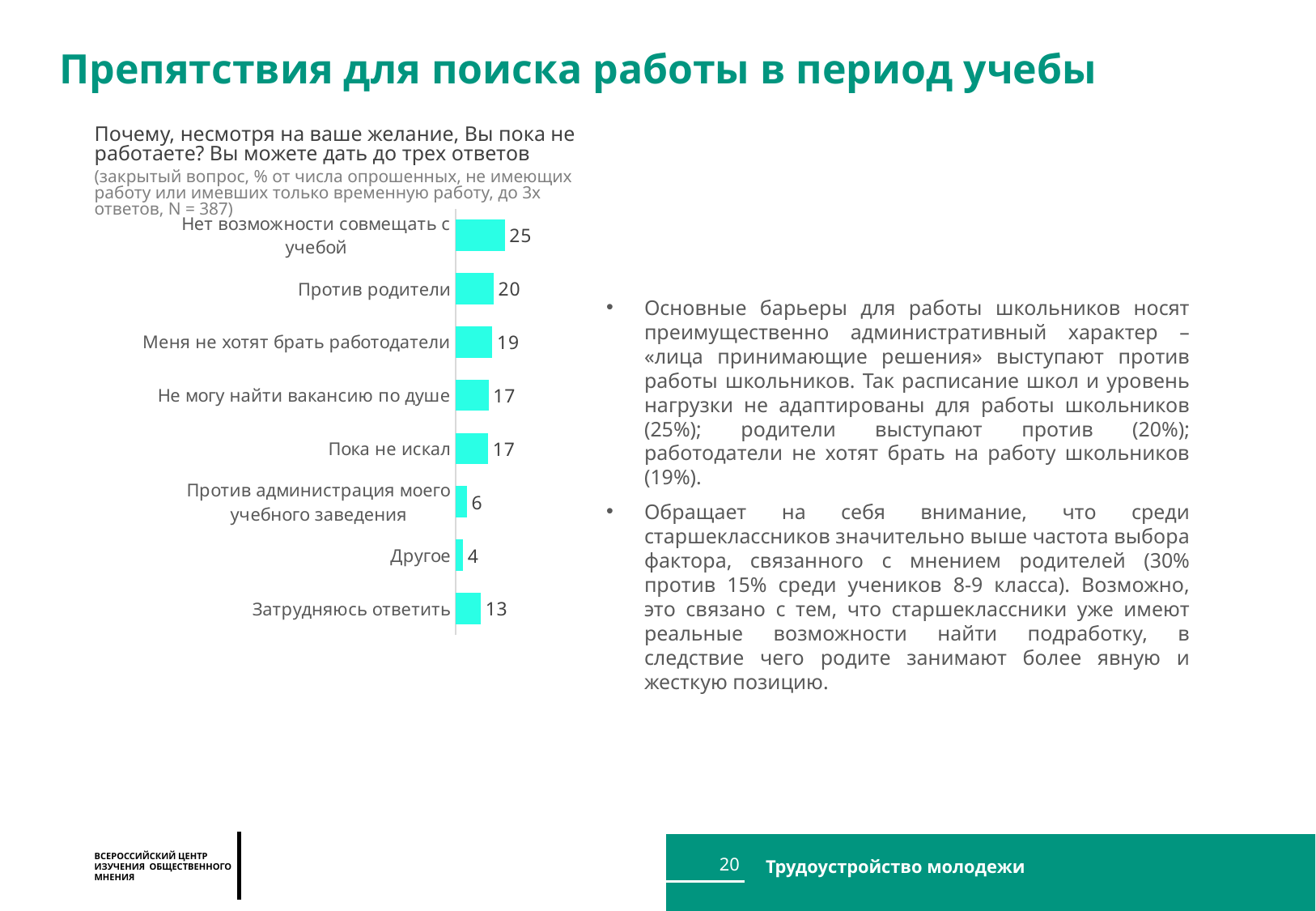
Какое значение у категории «Против администрация моего учебного заведения»? 6 На сколько значение «Затрудняюсь ответить» больше значения «Другое»? 9 На сколько значение «Нет возможности совмещать с учебой» больше значения «Против родители»? 5 Сколько категорий показано на диаграмме? 8 Какая категория имеет наибольшее значение на диаграмме? Нет возможности совмещать с учебой Какое значение у категории «Против родители»? 20 Какое значение у категории «Меня не хотят брать работодатели»? 19 Какое значение у категории «Затрудняюсь ответить»? 13 Какая категория имеет наименьшее значение на диаграмме? Другое Какого типа эта диаграмма? Столбчатая (bar chart) Какое значение N указано в подзаголовке диаграммы? N = 387 Что больше: значение «Меня не хотят брать работодатели» или «Пока не искал»? Меня не хотят брать работодатели